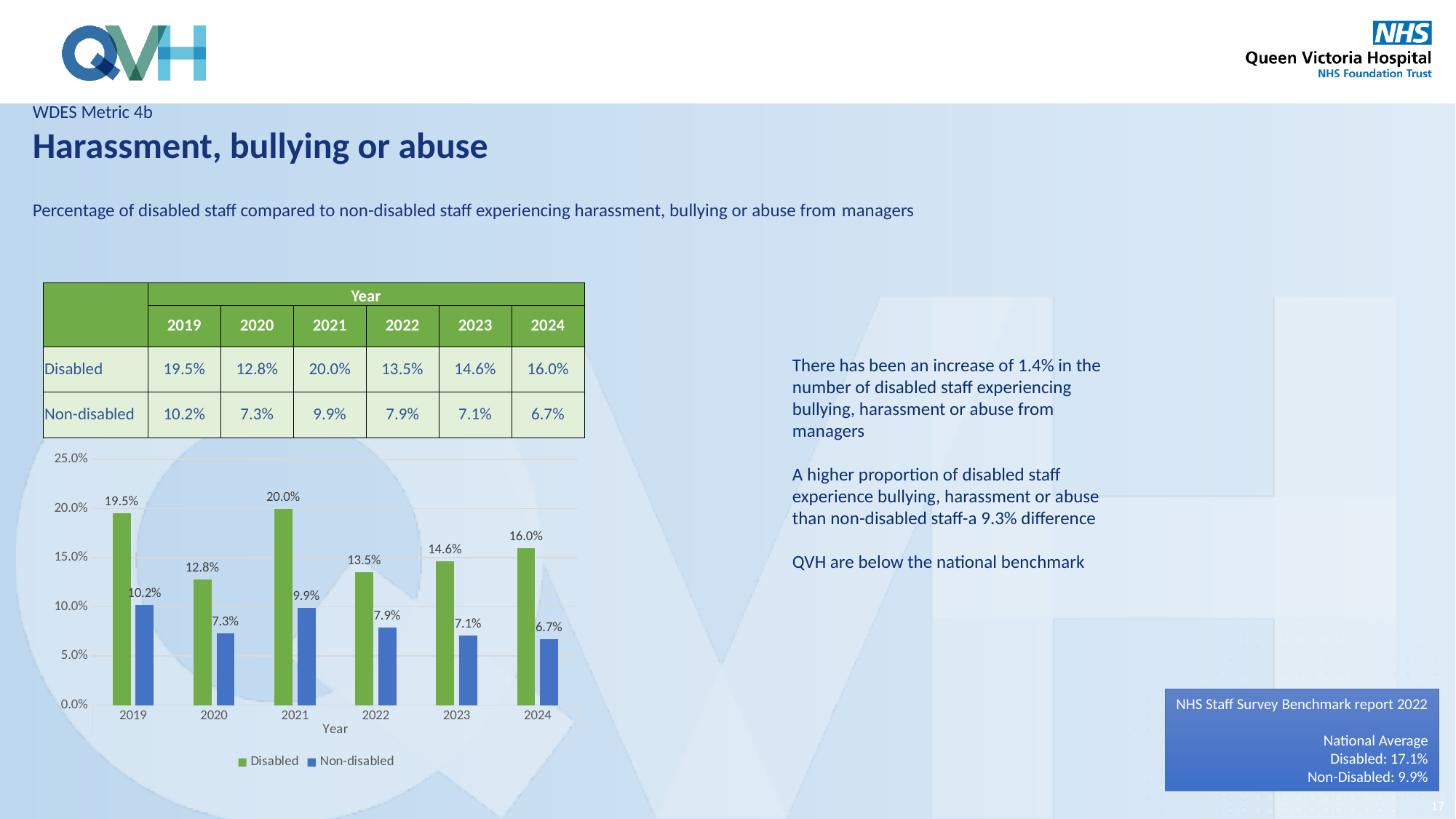
How many series does the chart legend list? 2 What is the difference between the Disabled and Non-disabled values in 2024? 9.3% What is the value for Non-disabled staff in 2024? 6.7% Is the value for Disabled staff in 2019 greater or less than 15.0%? greater In which year is the Non-disabled series lowest? 2024 Does the Non-disabled series rise or fall from 2022 to 2024? fall What is the value for Disabled staff in 2021? 20.0% What colour are the Disabled bars in the chart? green Which is larger in 2020, the Disabled value or the Non-disabled value? Disabled What kind of chart is shown on the slide? bar chart In which year is the Disabled series highest? 2021 How many years are shown on the x axis of the chart? 6